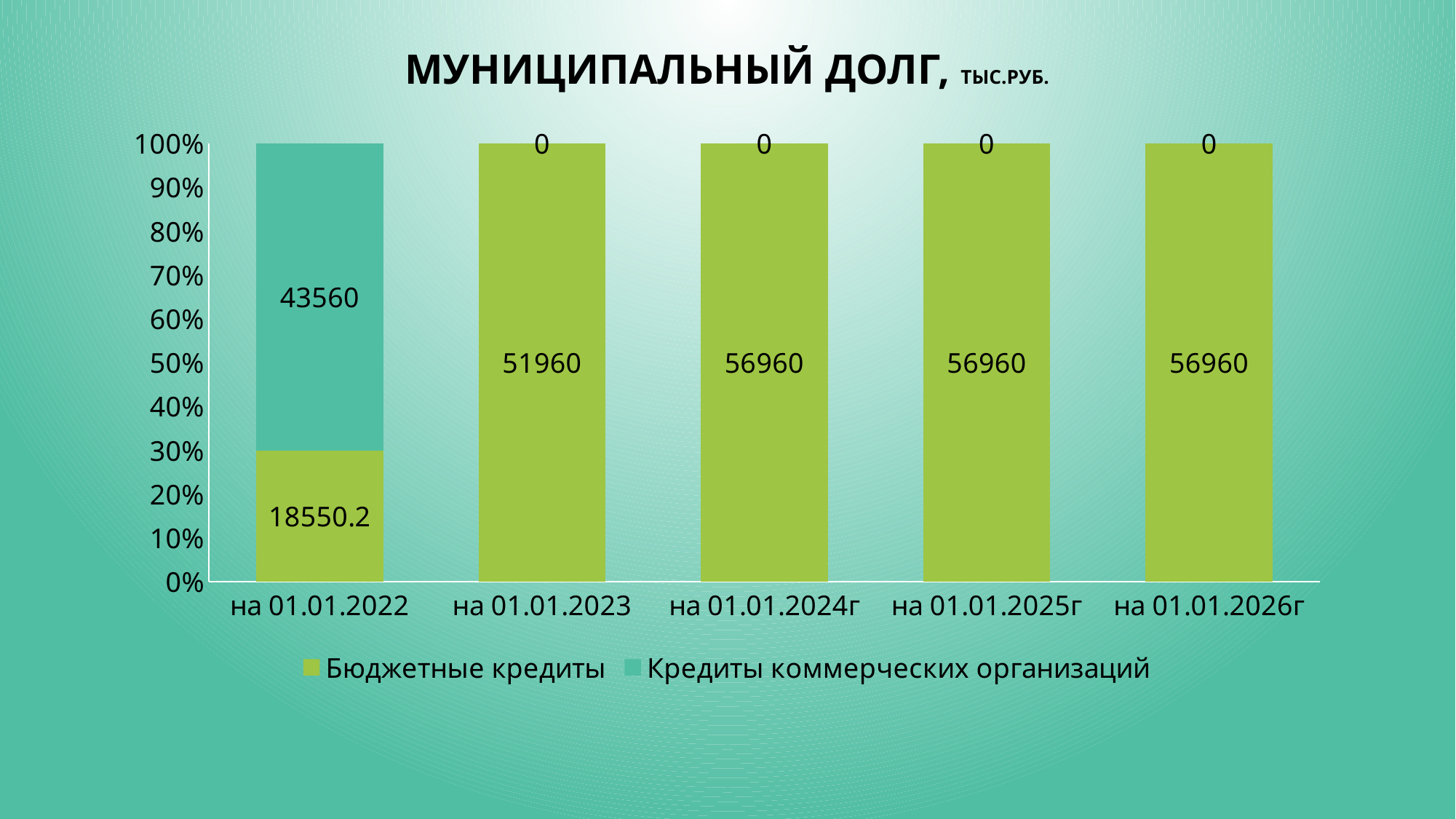
Which category has the lowest value of Бюджетные кредиты? на 01.01.2022 What kind of chart is shown on the slide? stacked bar chart What is the value of Бюджетные кредиты for на 01.01.2022? 18550.2 How many series does the legend list? 2 What is the total of the stacked bar for на 01.01.2022? 62110.2 What is the value of Бюджетные кредиты for на 01.01.2023? 51960 What is the value of Кредиты коммерческих организаций for на 01.01.2025г? 0 How many categories are shown on the x axis? 5 For на 01.01.2022, which is larger: Бюджетные кредиты or Кредиты коммерческих организаций? Кредиты коммерческих организаций What is the value of Кредиты коммерческих организаций for на 01.01.2022? 43560 What is the title of the chart? МУНИЦИПАЛЬНЫЙ ДОЛГ, тыс.руб. What is the difference between Бюджетные кредиты for на 01.01.2024г and for на 01.01.2023? 5000